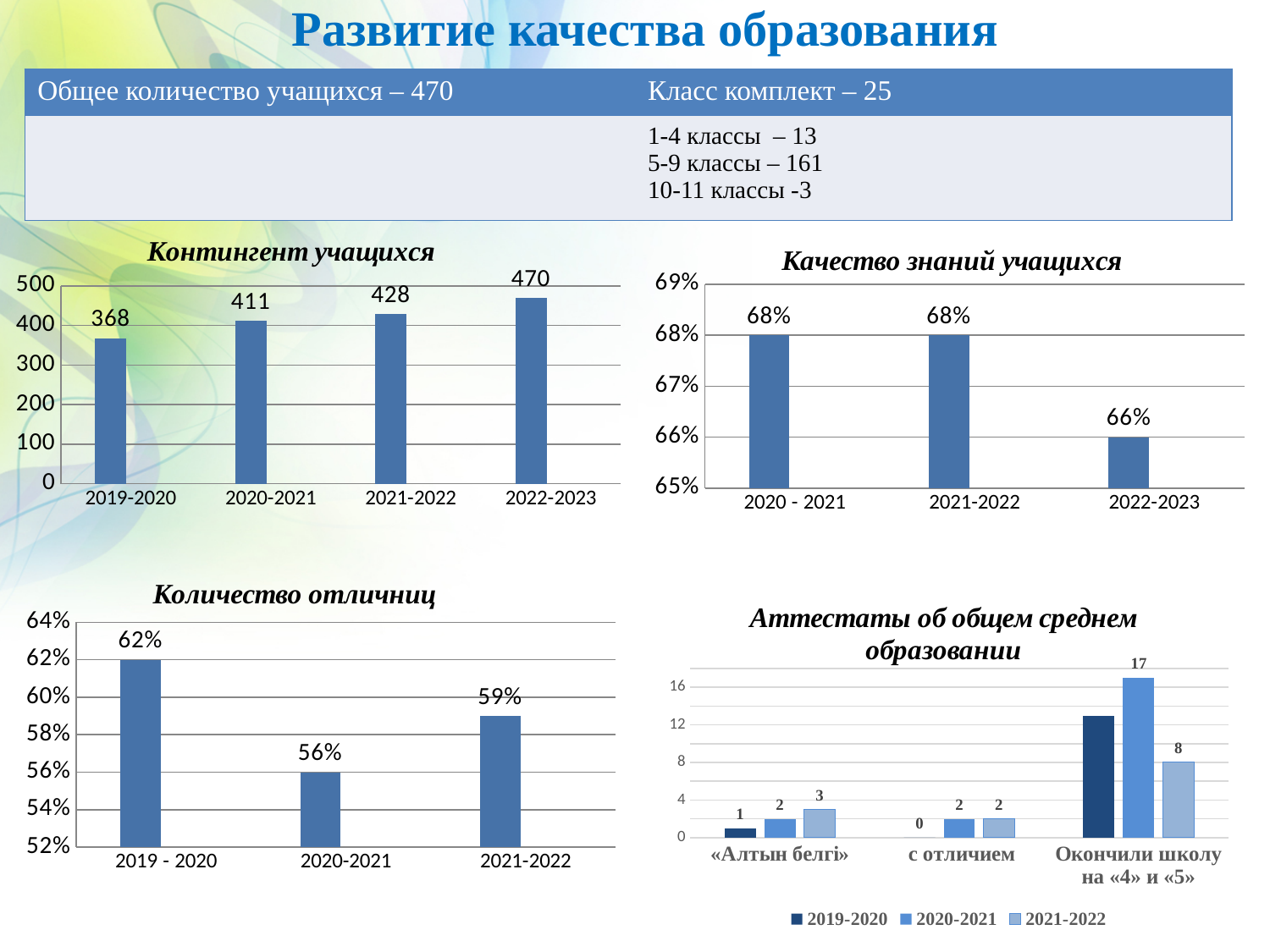
How many categories are shown in the chart 'Качество знаний учащихся'? 3 In the chart 'Аттестаты об общем среднем образовании', what is the value for 2020-2021 in the category 'Окончили школу на «4» и «5»'? 17 In the chart 'Количество отличниц', what is the difference between the values for 2019 - 2020 and 2021-2022? 3% In the chart 'Количество отличниц', what is the value for 2020-2021? 56% In the chart 'Качество знаний учащихся', what is the value for 2022-2023? 66% In the chart 'Контингент учащихся', what is the value for 2022-2023? 470 In the chart 'Контингент учащихся', what is the difference between the values for 2022-2023 and 2019-2020? 102 In the chart 'Контингент учащихся', do the values rise or fall from 2019-2020 to 2022-2023? rise In the chart 'Количество отличниц', which year has the highest value? 2019 - 2020 What kind of chart is 'Аттестаты об общем среднем образовании'? bar chart In the chart 'Контингент учащихся', which year has the lowest value? 2019-2020 How many series does the legend list in the chart 'Аттестаты об общем среднем образовании'? 3